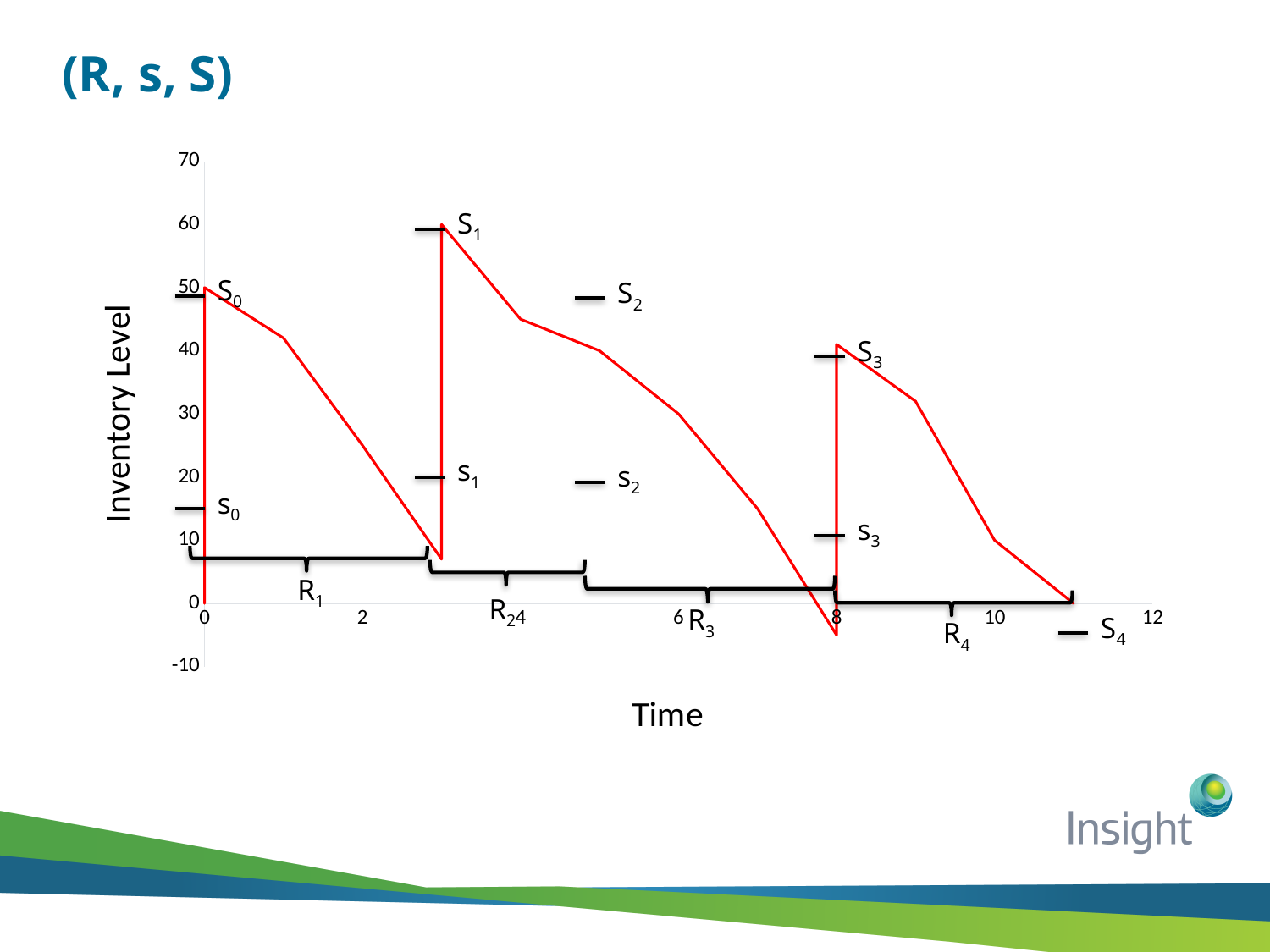
What is the title of the vertical axis? Inventory Level What kind of chart is shown on the slide? line chart Is the inventory level at time 4 greater or less than 30? greater Is the peak inventory level marked S1 greater or less than 50? greater How many review periods labelled R are marked along the time axis? 4 Does the inventory level rise or fall between time 8 and time 10? fall Is the lowest point of the red line greater or less than 0? less What is the title of the horizontal axis? Time Does the inventory level rise or fall between time 0 and time 2? fall